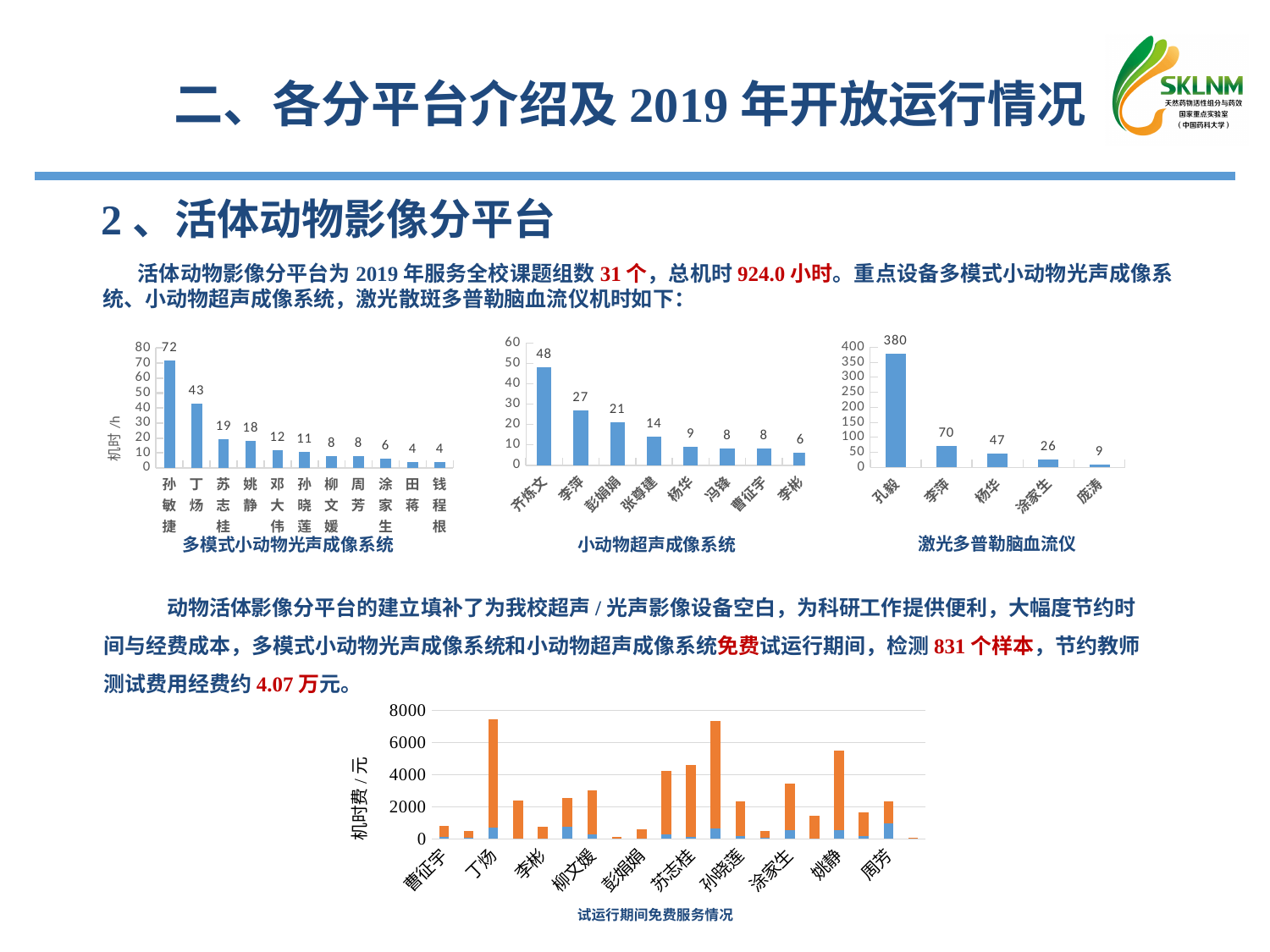
In the 小动物超声成像系统 chart, how many categories are plotted? 8 In the 多模式小动物光声成像系统 chart, how many categories are plotted? 11 In the 激光多普勒脑血流仪 chart, what is the value for 孔毅? 380 In the 小动物超声成像系统 chart, which category has the highest value? 齐炼文 In the 多模式小动物光声成像系统 chart, what is the value for 孙敏捷? 72 What kind of chart is the 试运行期间免费服务情况 chart at the bottom of the slide? stacked bar chart In the 小动物超声成像系统 chart, which is larger, 李萍 or 张尊建? 李萍 In the 激光多普勒脑血流仪 chart, do the values rise or fall from left to right? fall In the 小动物超声成像系统 chart, what is the value for 彭娟娟? 21 In the 激光多普勒脑血流仪 chart, what is the difference between 李萍 and 杨华? 23 In the 多模式小动物光声成像系统 chart, which category has the lowest value? 田蒋 and 钱程根 (both 4) In the 多模式小动物光声成像系统 chart, what is the difference between 孙敏捷 and 丁炀? 29